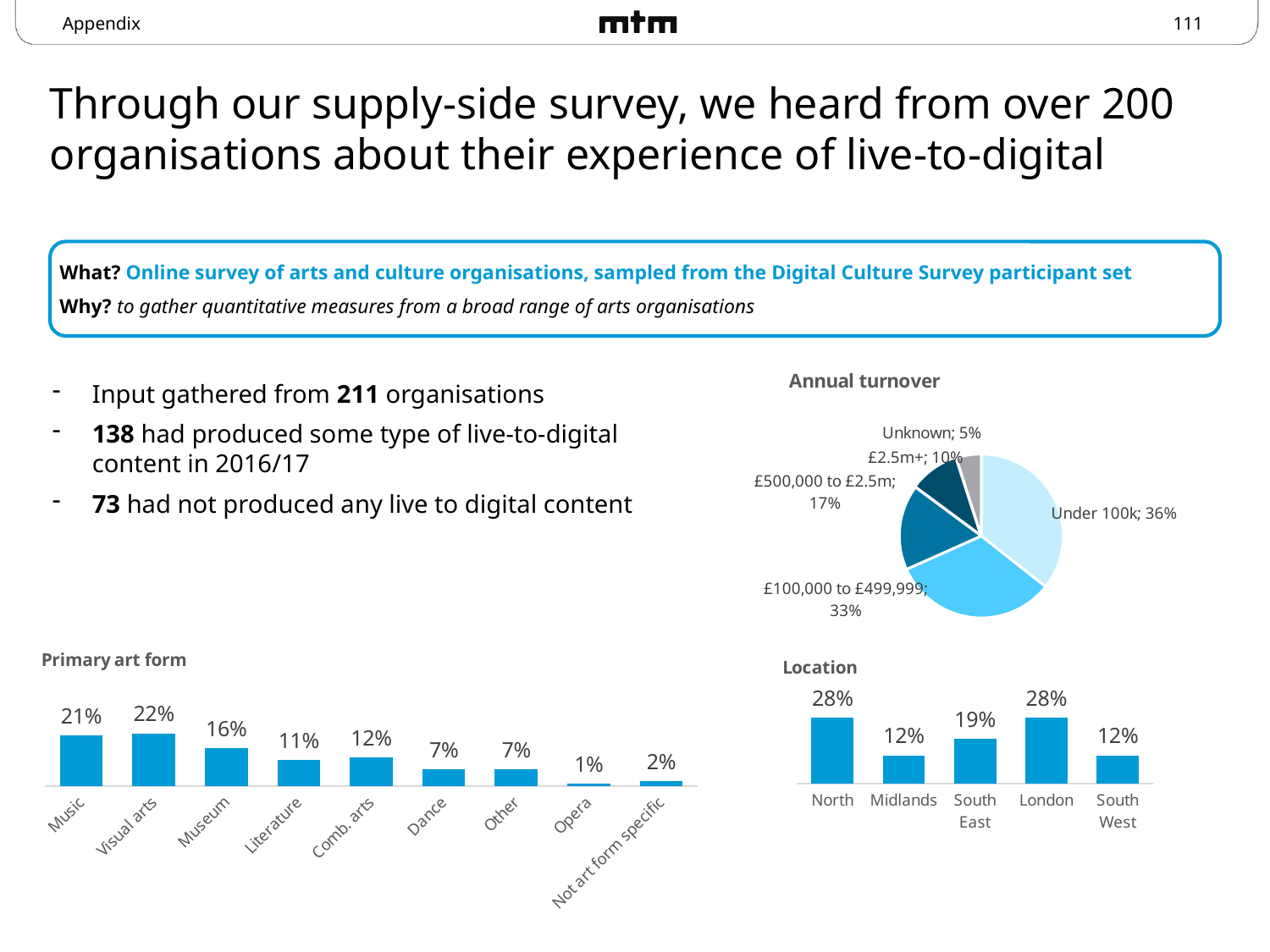
In the Primary art form chart, what is the difference between Music and Literature? 10% In the Primary art form chart, which art form has the highest value? Visual arts In the Primary art form chart, how many categories are shown? 9 In the Primary art form chart, which art form has the lowest value? Opera In the Location chart, which is larger, Midlands or South East? South East In the Annual turnover chart, which turnover band has the largest share? Under 100k In the Location chart, what is the value for South East? 19% What kind of chart is the Location chart? Bar chart In the Annual turnover chart, what is the share for £500,000 to £2.5m? 17% What kind of chart is the Annual turnover chart? Pie chart In the Annual turnover chart, what share of organisations have a turnover under 100k? 36% In the Primary art form chart, what is the value for Museum? 16%